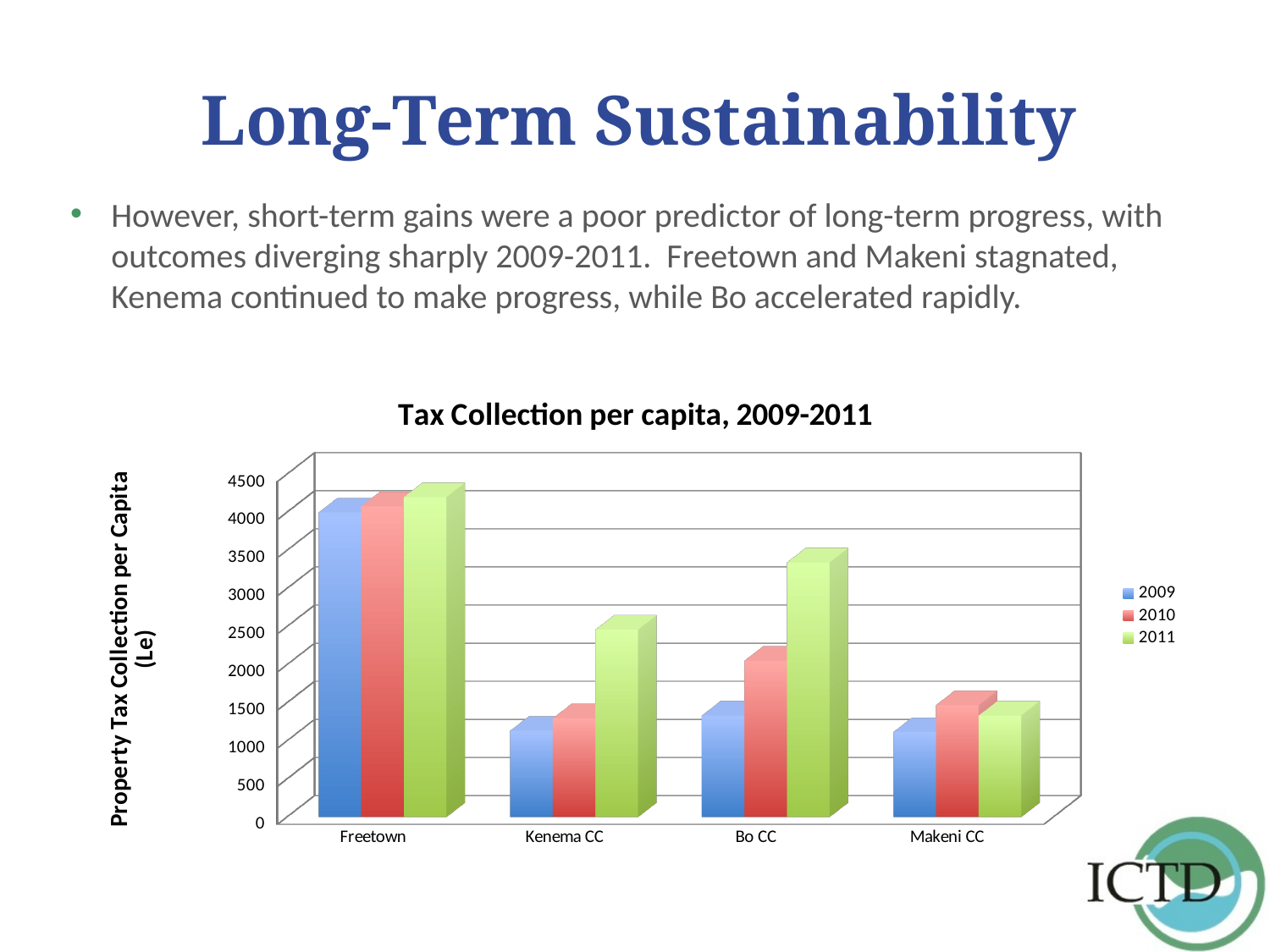
Is the 2009 value for Freetown greater or less than 3500? greater Which council has the lowest property tax collection per capita in 2011? Makeni CC What type of chart is shown on the slide? Bar chart Is the 2011 value for Kenema CC greater or less than 2000? greater Which is larger in 2011: the value for Bo CC or the value for Kenema CC? Bo CC How many councils (categories) are shown on the x axis? 4 Which council has the highest property tax collection per capita in 2011? Freetown Is the 2009 value for Makeni CC greater or less than 1500? less How many series does the legend list? 3 Do the values for Bo CC rise or fall from 2009 to 2011? rise What is the title of the chart? Tax Collection per capita, 2009-2011